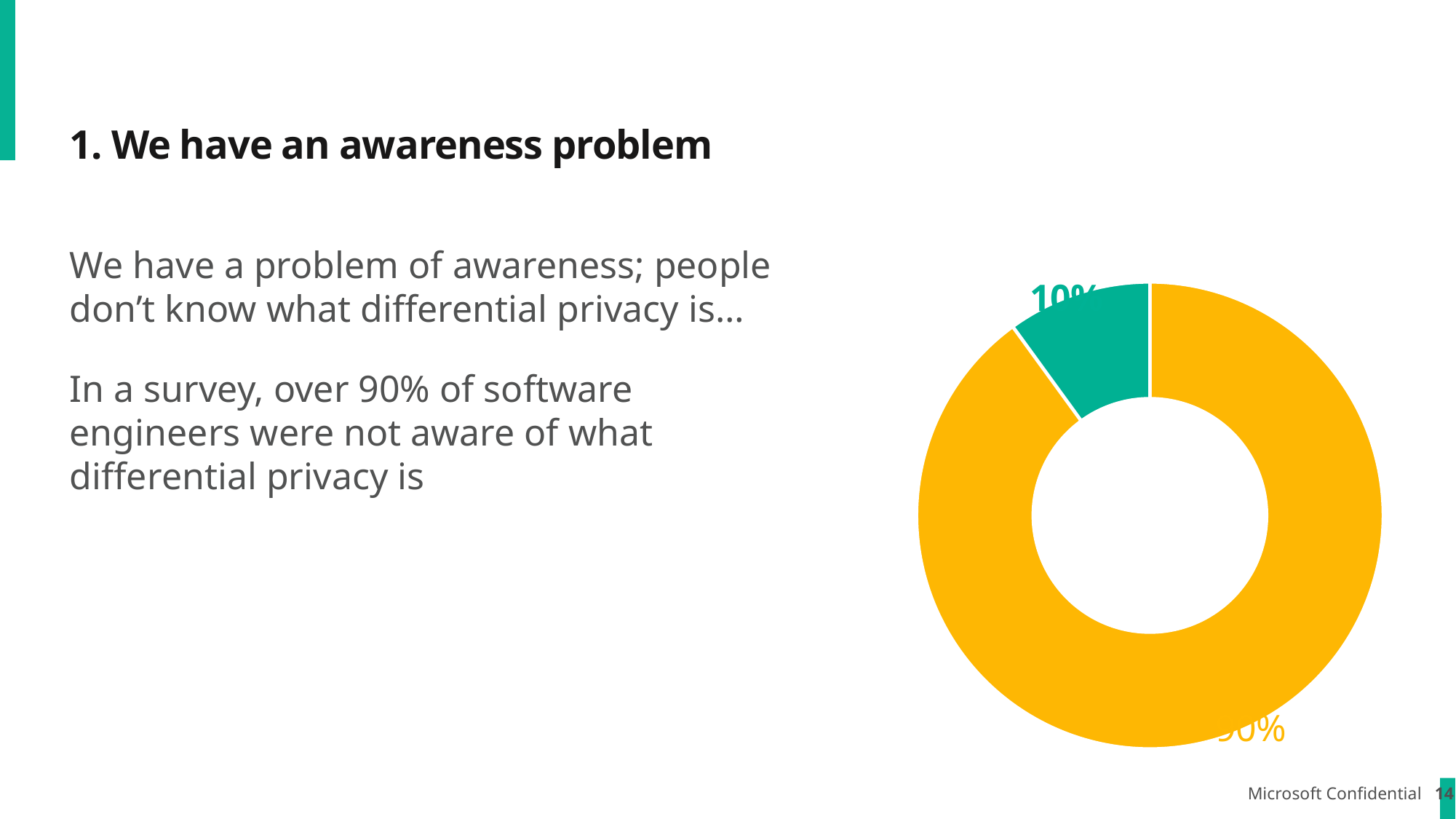
How many slices does the doughnut chart have? 2 What is the difference in percentage points between the yellow slice and the teal slice? 80 percentage points What percentage is shown for the teal slice of the doughnut chart? 10% What is the value of the smallest slice in the doughnut chart? 10% Does the doughnut chart have a legend? No What kind of chart is shown on the slide? Doughnut (pie) chart Which slice is larger in the doughnut chart, the yellow one or the teal one? The yellow one What is the value of the largest slice in the doughnut chart? 90% What percentage is shown for the yellow slice of the doughnut chart? 90% What colour is the largest slice of the doughnut chart? Yellow What share of the doughnut chart does the teal slice represent? 10%